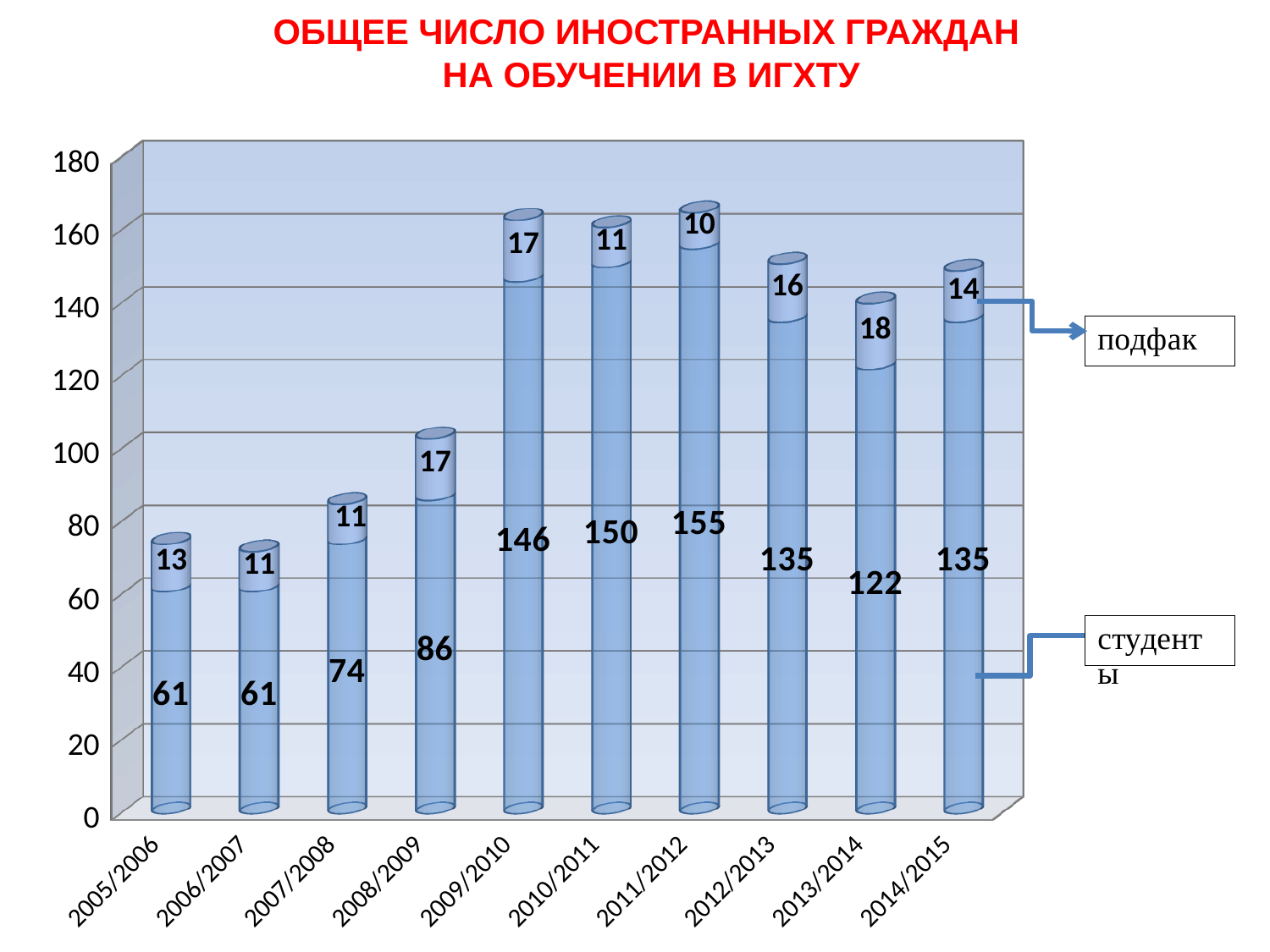
What is the total of the stacked bar for 2005/2006? 74 Which is larger, the студенты value for 2012/2013 or for 2013/2014? 2012/2013 What is the total of the stacked bar for 2011/2012? 165 How many academic years are shown on the x axis? 10 What type of chart is shown on the slide? bar chart Which academic year has the highest value for студенты? 2011/2012 What is the value for подфак in 2013/2014? 18 How many series are labelled on the chart? 2 What is the difference between the студенты values for 2009/2010 and 2013/2014? 24 Which academic year has the lowest value for подфак? 2011/2012 What is the value for студенты in 2011/2012? 155 What is the value for студенты in 2008/2009? 86